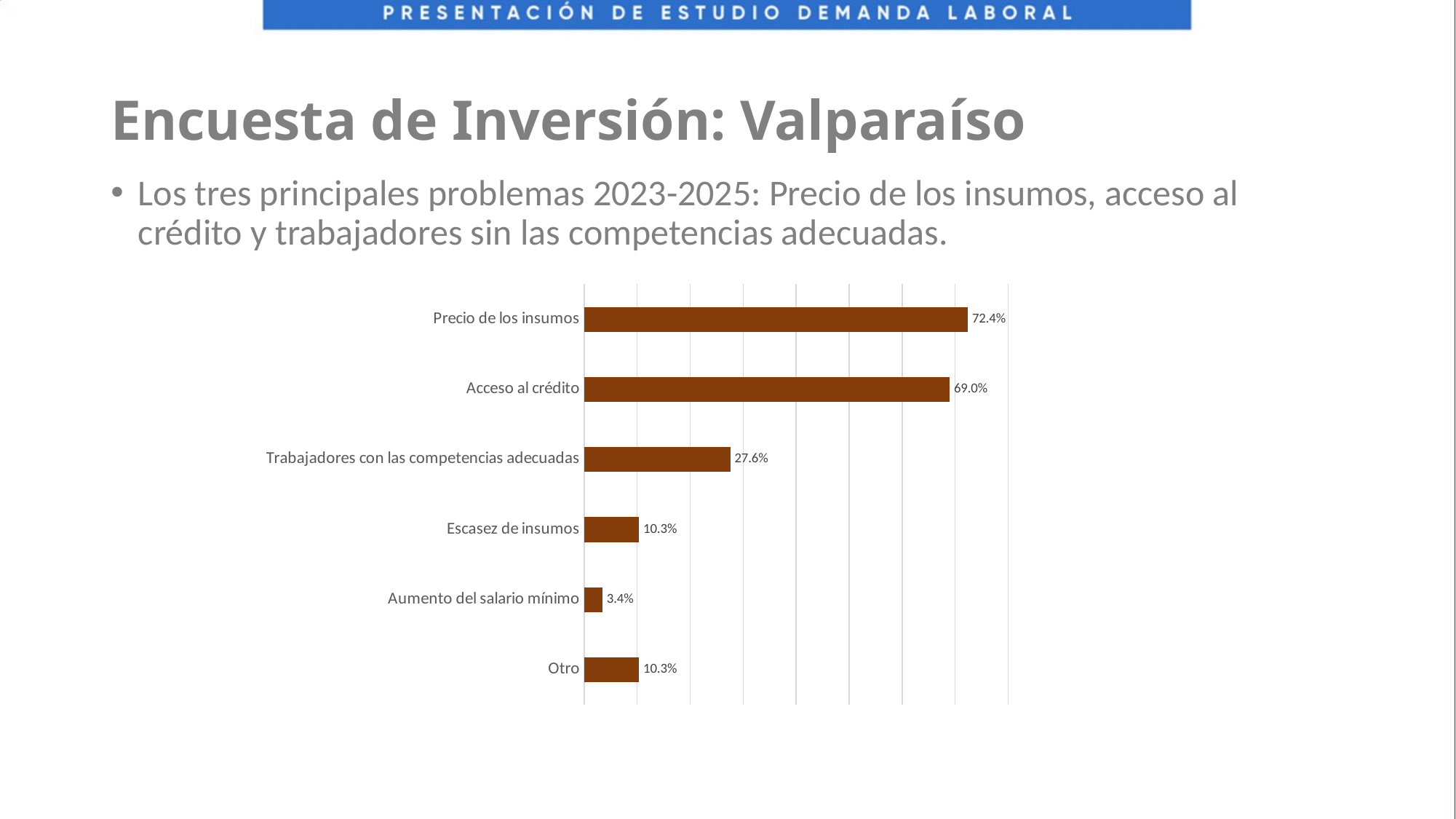
Which is larger, the value for Escasez de insumos or the value for Aumento del salario mínimo? Escasez de insumos How many categories are shown in the chart? 6 What is the value for Precio de los insumos? 72.4% What is the value for Acceso al crédito? 69.0% What kind of chart is shown on the slide? Bar chart What is the difference between the values for Acceso al crédito and Trabajadores con las competencias adecuadas? 41.4% What is the difference between the values for Precio de los insumos and Acceso al crédito? 3.4% What is the value for Aumento del salario mínimo? 3.4% Which category has the lowest value? Aumento del salario mínimo What colour are the bars in the chart? Brown What is the value for Trabajadores con las competencias adecuadas? 27.6% Which category has the highest value? Precio de los insumos